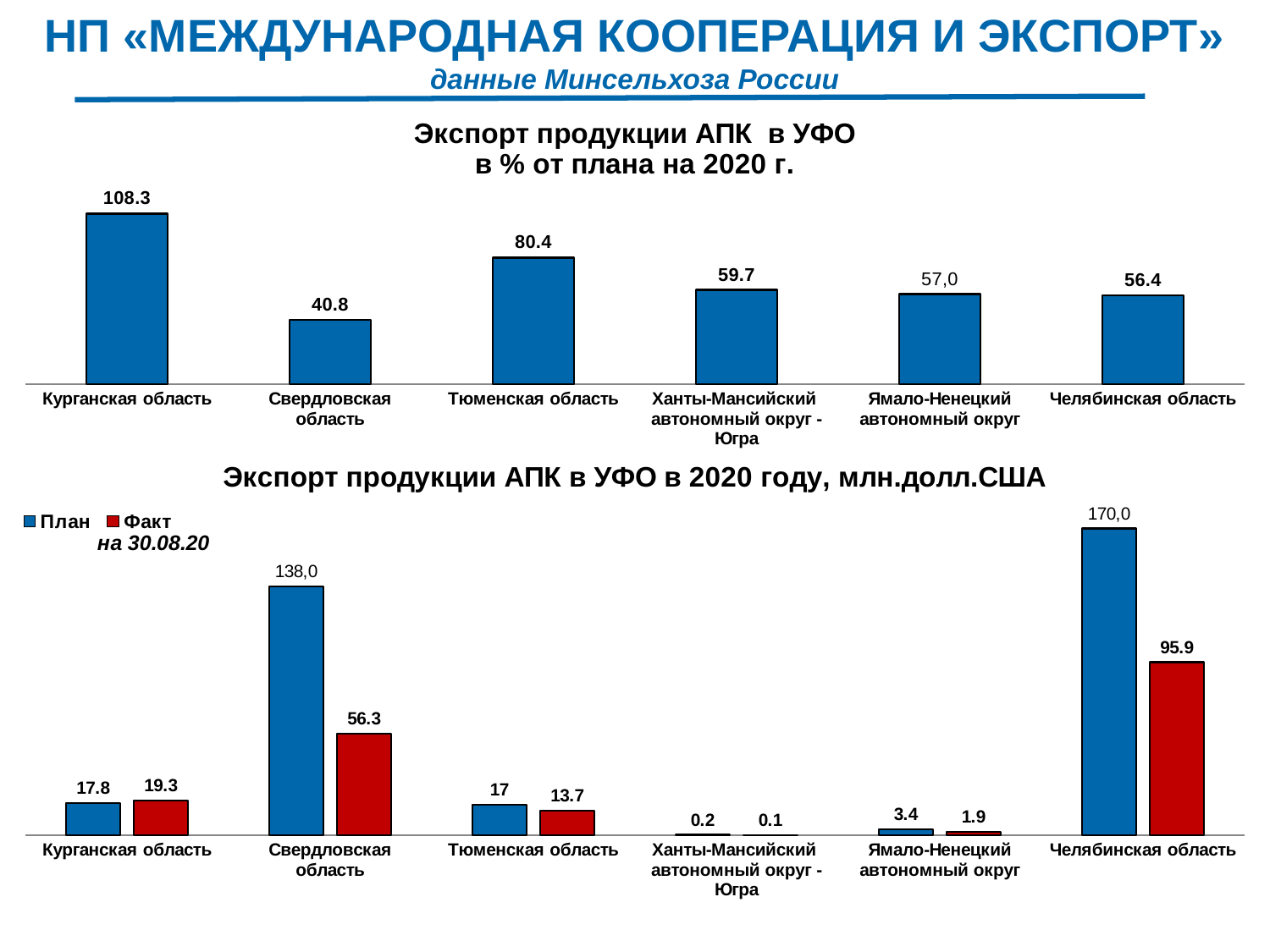
In the bottom chart (Экспорт продукции АПК в УФО в 2020 году, млн.долл.США), how many series does the legend list? 2 In the top chart (Экспорт продукции АПК в УФО в % от плана на 2020 г.), how many regions are shown? 6 In the top chart (Экспорт продукции АПК в УФО в % от плана на 2020 г.), what is the value for Курганская область? 108.3 In the top chart (Экспорт продукции АПК в УФО в % от плана на 2020 г.), which region has the highest value? Курганская область What type of chart is the top chart (Экспорт продукции АПК в УФО в % от плана на 2020 г.)? Bar chart In the top chart (Экспорт продукции АПК в УФО в % от плана на 2020 г.), which region has the lowest value? Свердловская область In the bottom chart (Экспорт продукции АПК в УФО в 2020 году, млн.долл.США), which is larger for Курганская область, План or Факт? Факт In the bottom chart (Экспорт продукции АПК в УФО в 2020 году, млн.долл.США), what is the Факт value for Челябинская область? 95.9 In the bottom chart (Экспорт продукции АПК в УФО в 2020 году, млн.долл.США), what is the План value for Свердловская область? 138,0 In the top chart (Экспорт продукции АПК в УФО в % от плана на 2020 г.), what is the value for Ямало-Ненецкий автономный округ? 57,0 In the bottom chart (Экспорт продукции АПК в УФО в 2020 году, млн.долл.США), which region has the highest План value? Челябинская область In the bottom chart (Экспорт продукции АПК в УФО в 2020 году, млн.долл.США), what is the difference between the План and Факт values for Тюменская область? 3.3